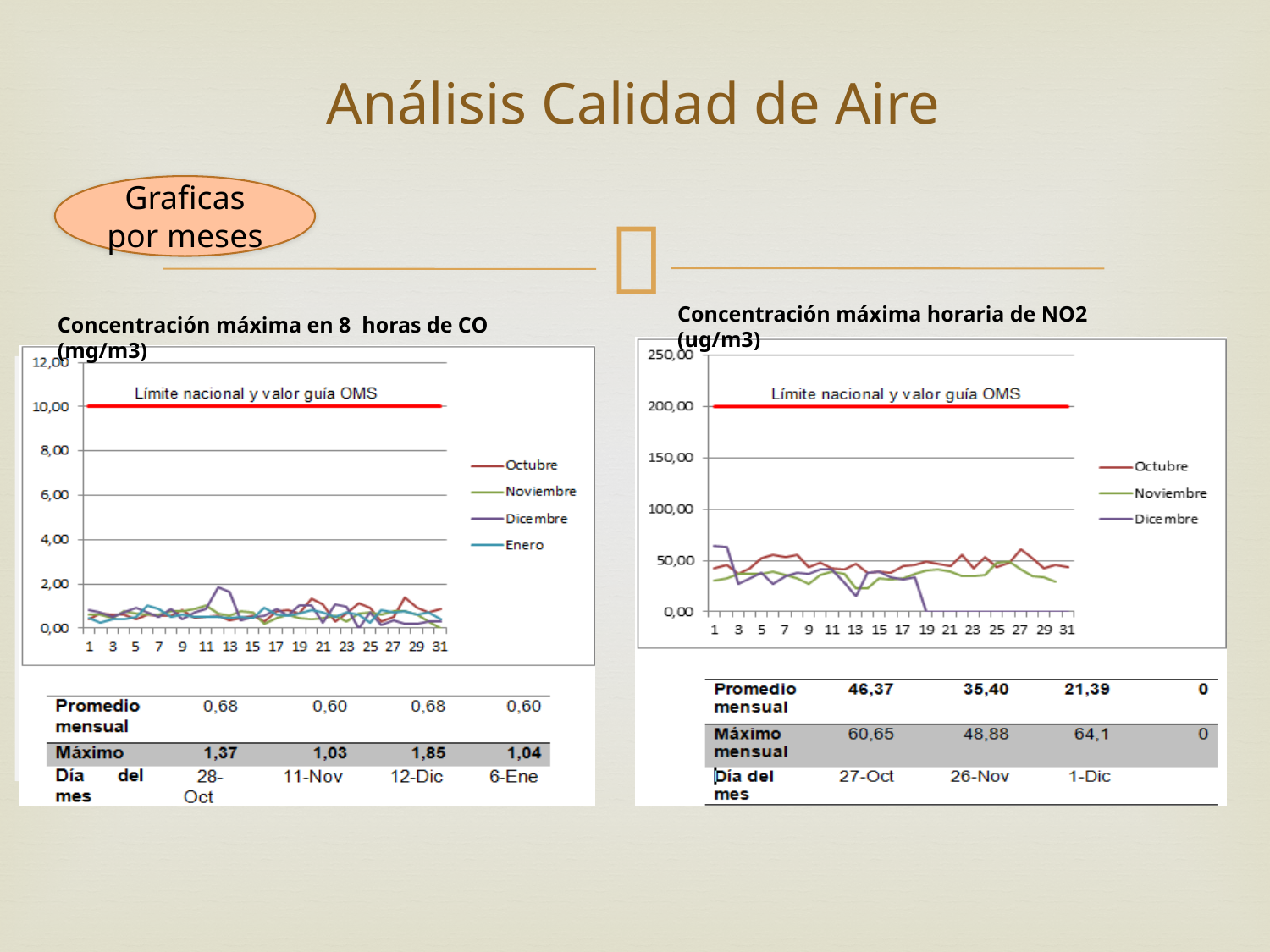
In the right NO2 chart, which series falls to 0,00 for the second half of the month? Dicembre In the left CO chart, at what y-axis value is the red 'Límite nacional y valor guía OMS' line drawn? 10,00 How many days does the x axis of the left CO chart span? 31 In the right NO2 chart, are the Noviembre values greater or less than 150,00? less Which series is listed in the legend of the left CO chart but not in the legend of the right NO2 chart? Enero How many series does the legend of the left CO chart list? 4 What is the highest value shown on the y axis of the right NO2 chart? 250,00 In the right NO2 chart, at what y-axis value is the red 'Límite nacional y valor guía OMS' line drawn? 200,00 How many series does the legend of the right NO2 chart list? 3 In the left CO chart, are the Dicembre values greater or less than 4,00? less What kind of chart is the 'Concentración máxima en 8 horas de CO (mg/m3)' chart on the left? line chart In the right NO2 chart, are the Octubre values greater or less than 100,00? less